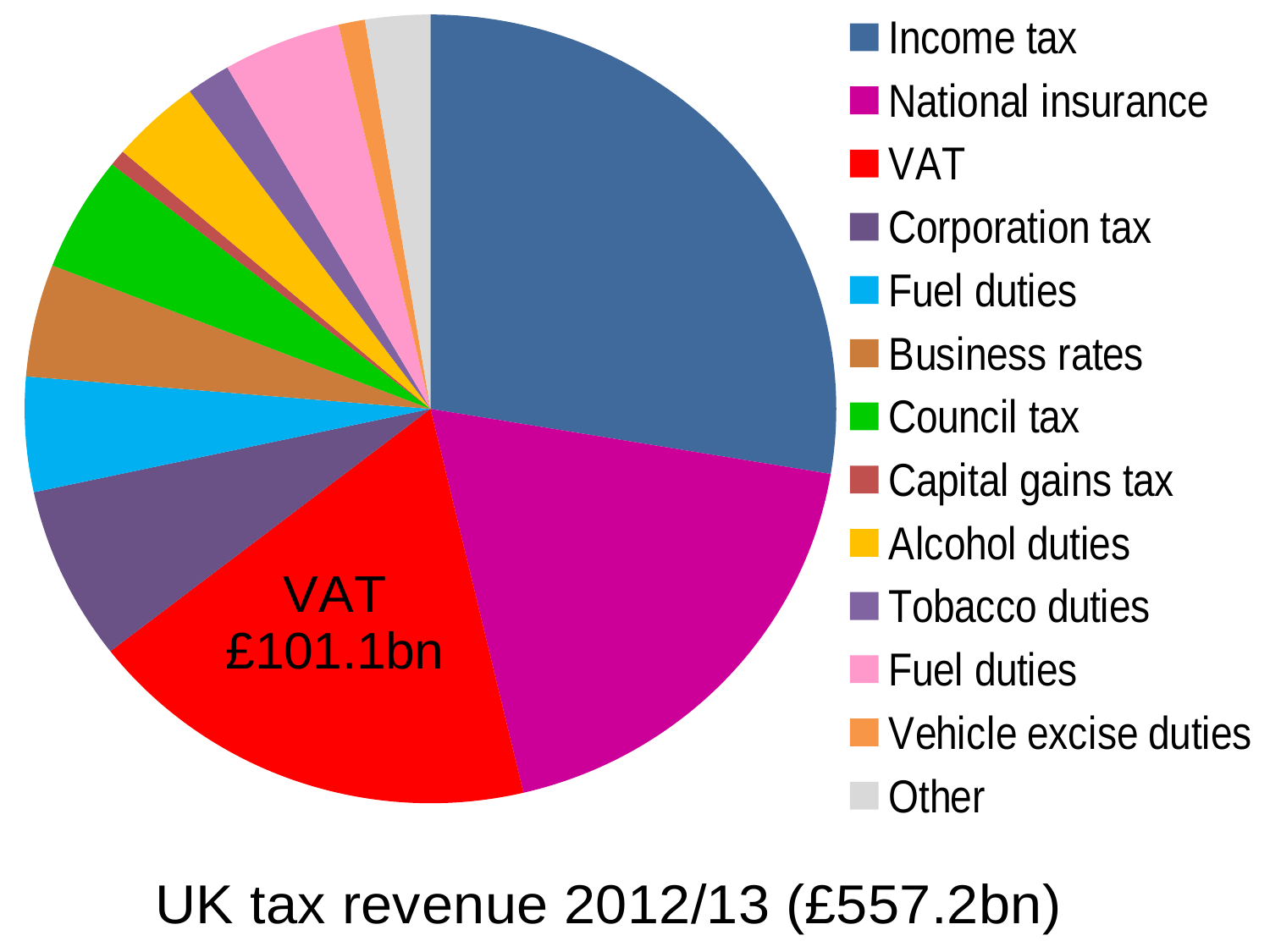
What is the total UK tax revenue shown in the chart title? £557.2bn Which is larger, VAT or Corporation tax? VAT Which category has the largest slice of the pie? Income tax Which is larger, Council tax or Capital gains tax? Council tax What is the title of the chart? UK tax revenue 2012/13 (£557.2bn) Which category has the smallest slice of the pie? Capital gains tax Which is larger, Income tax or National insurance? Income tax What colour is the VAT slice? red What value is shown for VAT? £101.1bn How many entries does the legend list? 13 What share of the total £557.2bn does VAT (£101.1bn) represent, to one decimal place? 18.1% What kind of chart is shown on the slide? pie chart